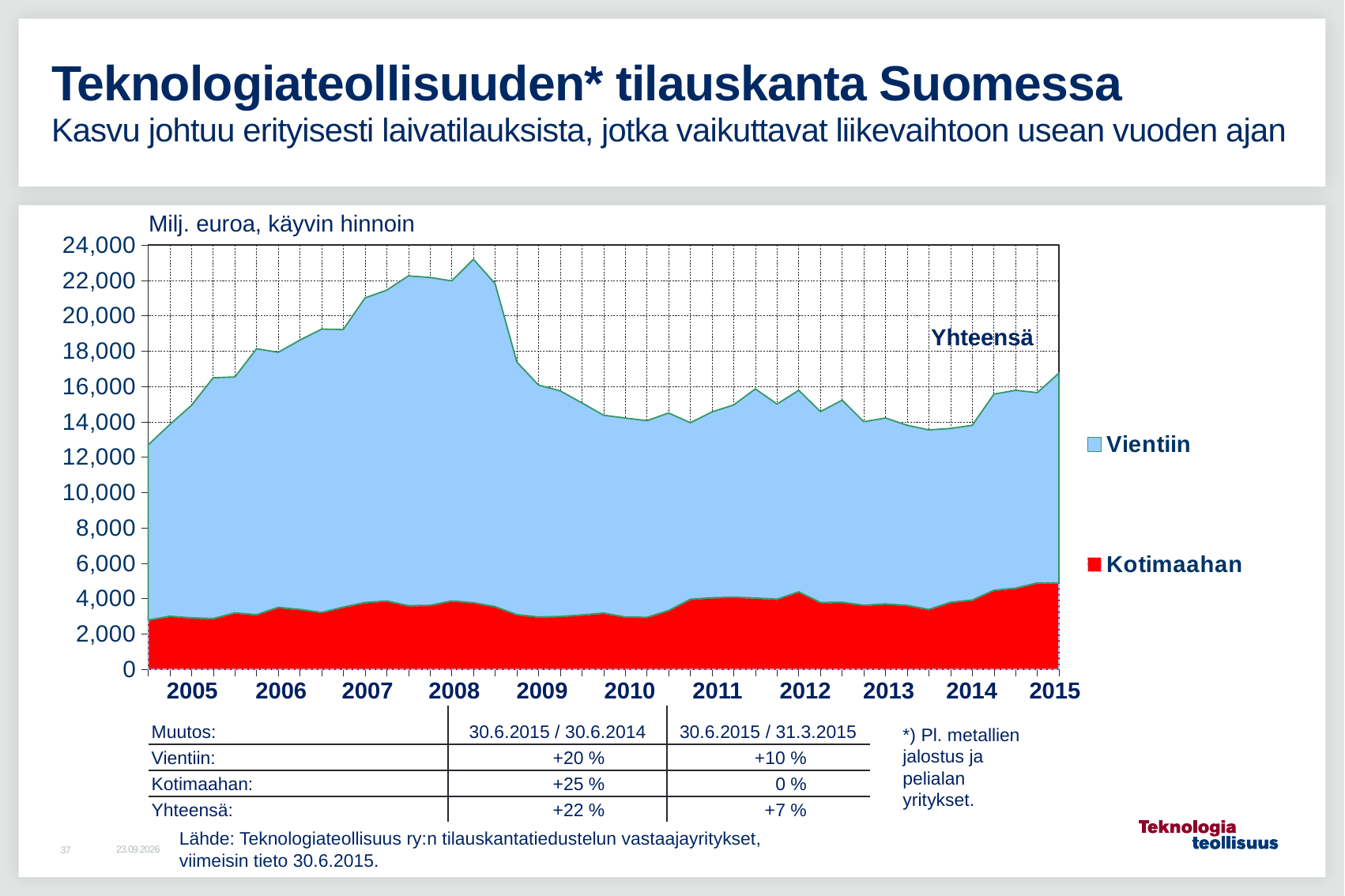
Is the Kotimaahan value at the end of the series in 2015 greater or less than 4,000? greater In which year does the total (Yhteensä) order backlog reach its highest point? 2008 Which two series are listed in the chart's legend? Vientiin and Kotimaahan Is the total value at the start of 2005 greater or less than 14,000? less How many series does the chart's legend list? 2 Does the total order backlog rise or fall between 2005 and the peak in 2008? rise Which series is larger throughout the chart, Vientiin or Kotimaahan? Vientiin What unit is stated above the chart's y axis? Milj. euroa, käyvin hinnoin Is the peak total value in 2008 greater or less than 22,000? greater What kind of chart is shown on the slide? Stacked area chart